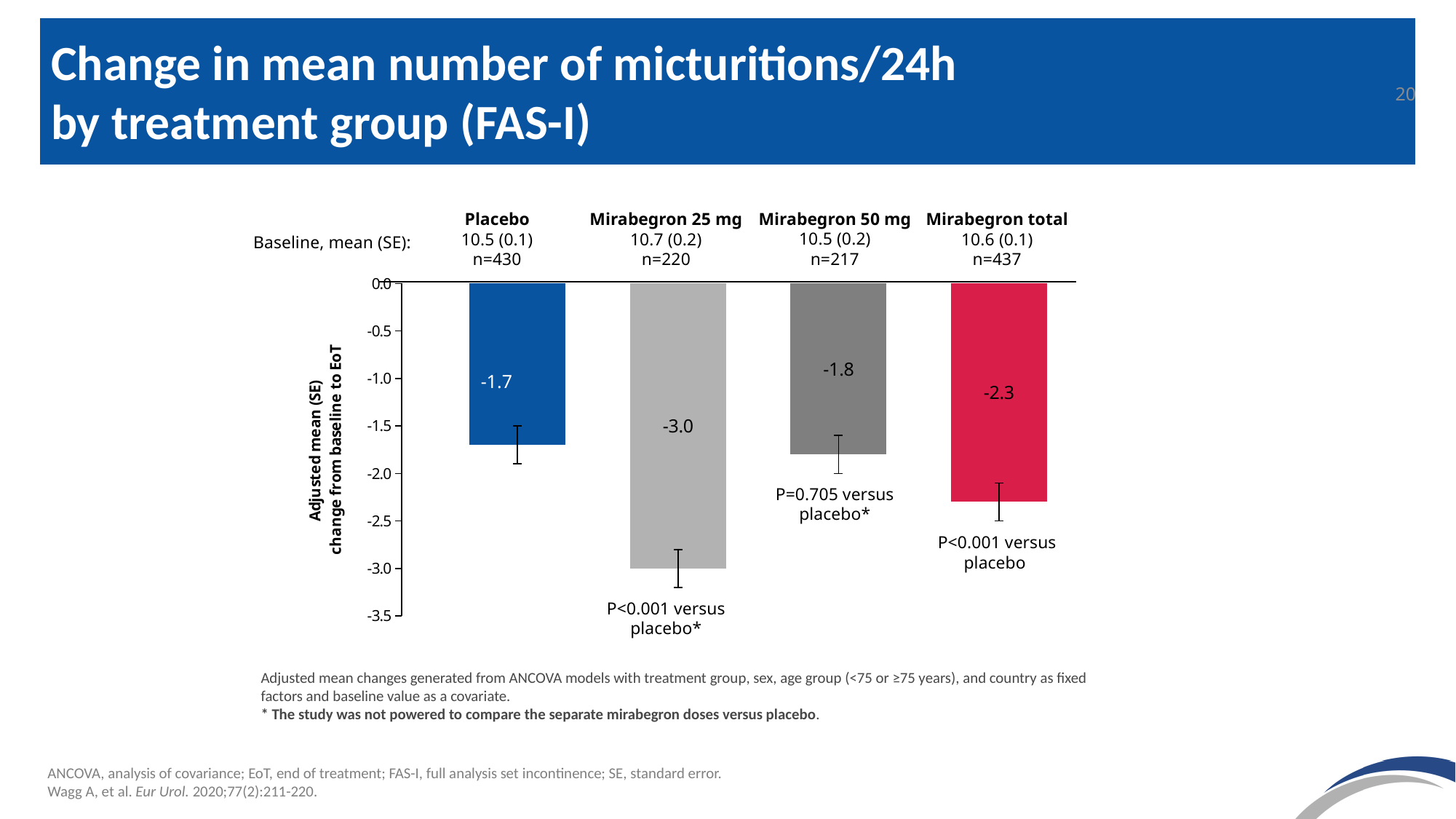
What is the difference between the adjusted mean change for Mirabegron 25 mg and Placebo? 1.3 What is the adjusted mean change from baseline for Mirabegron 25 mg? -3.0 What type of chart is shown on the slide? Bar chart Which treatment group shows the largest reduction in mean number of micturitions/24h? Mirabegron 25 mg What is the adjusted mean change from baseline for the Placebo group? -1.7 What is the baseline mean (SE) for the Mirabegron 25 mg group? 10.7 (0.2) What is the adjusted mean change from baseline for Mirabegron 50 mg? -1.8 What is the adjusted mean change from baseline for Mirabegron total? -2.3 Which treatment group shows the smallest reduction in mean number of micturitions/24h? Placebo Which group has a larger reduction from baseline, Mirabegron 50 mg or Mirabegron total? Mirabegron total What is the difference between the adjusted mean change for Mirabegron total and Placebo? 0.6 How many treatment groups are plotted in the chart? 4